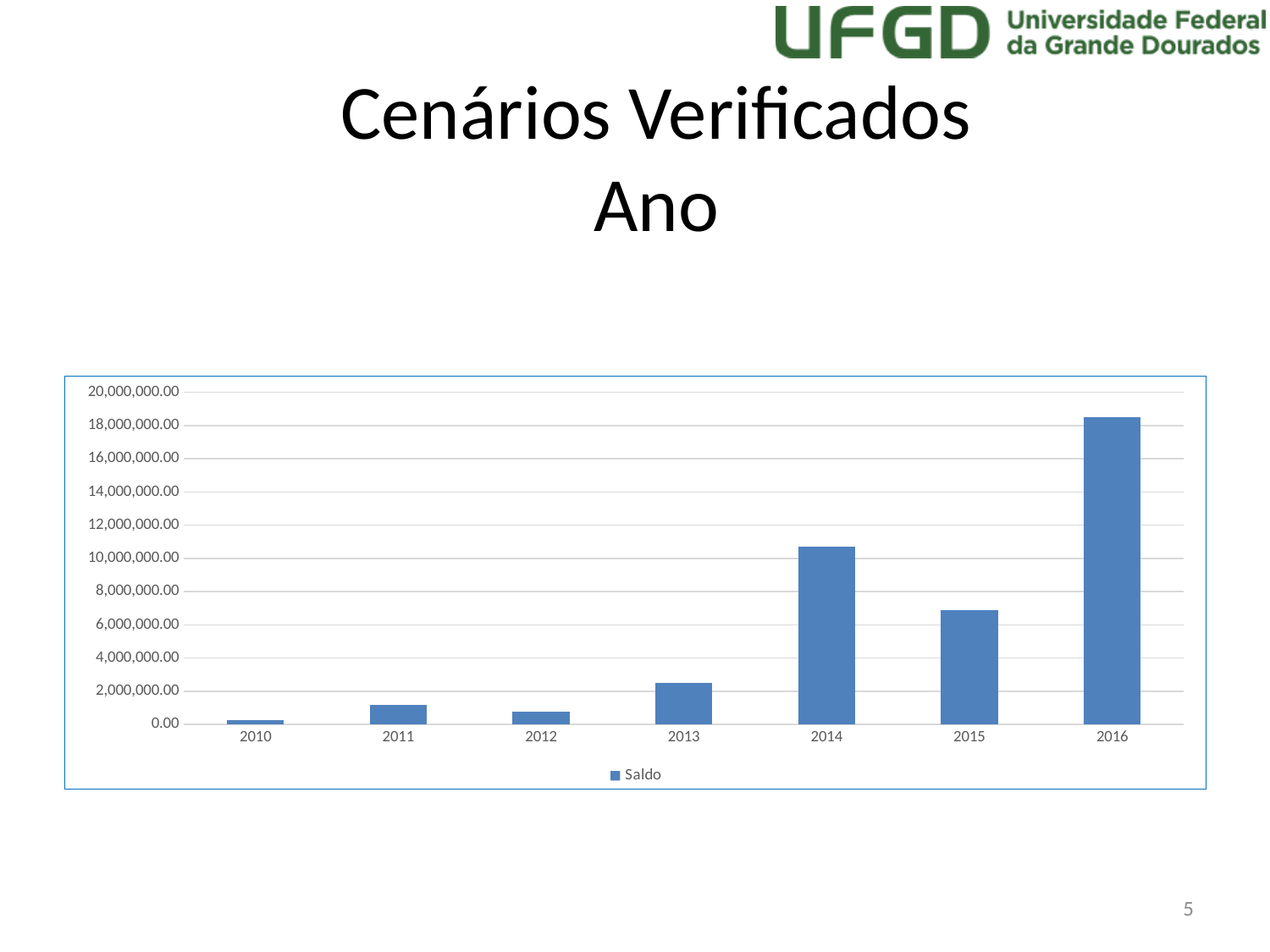
Is the Saldo value for 2014 greater or less than 10,000,000.00? greater How many series does the chart's legend list? 1 Which year has a larger Saldo value, 2014 or 2015? 2014 What kind of chart is shown on the slide? Bar chart What is the name of the series shown in the chart's legend? Saldo Is the Saldo value for 2015 greater or less than 8,000,000.00? less Is the Saldo value for 2013 greater or less than 2,000,000.00? greater How many years are shown on the x axis of the chart? 7 Which year has the highest Saldo value? 2016 Which year has the lowest Saldo value? 2010 Which year has a larger Saldo value, 2011 or 2012? 2011